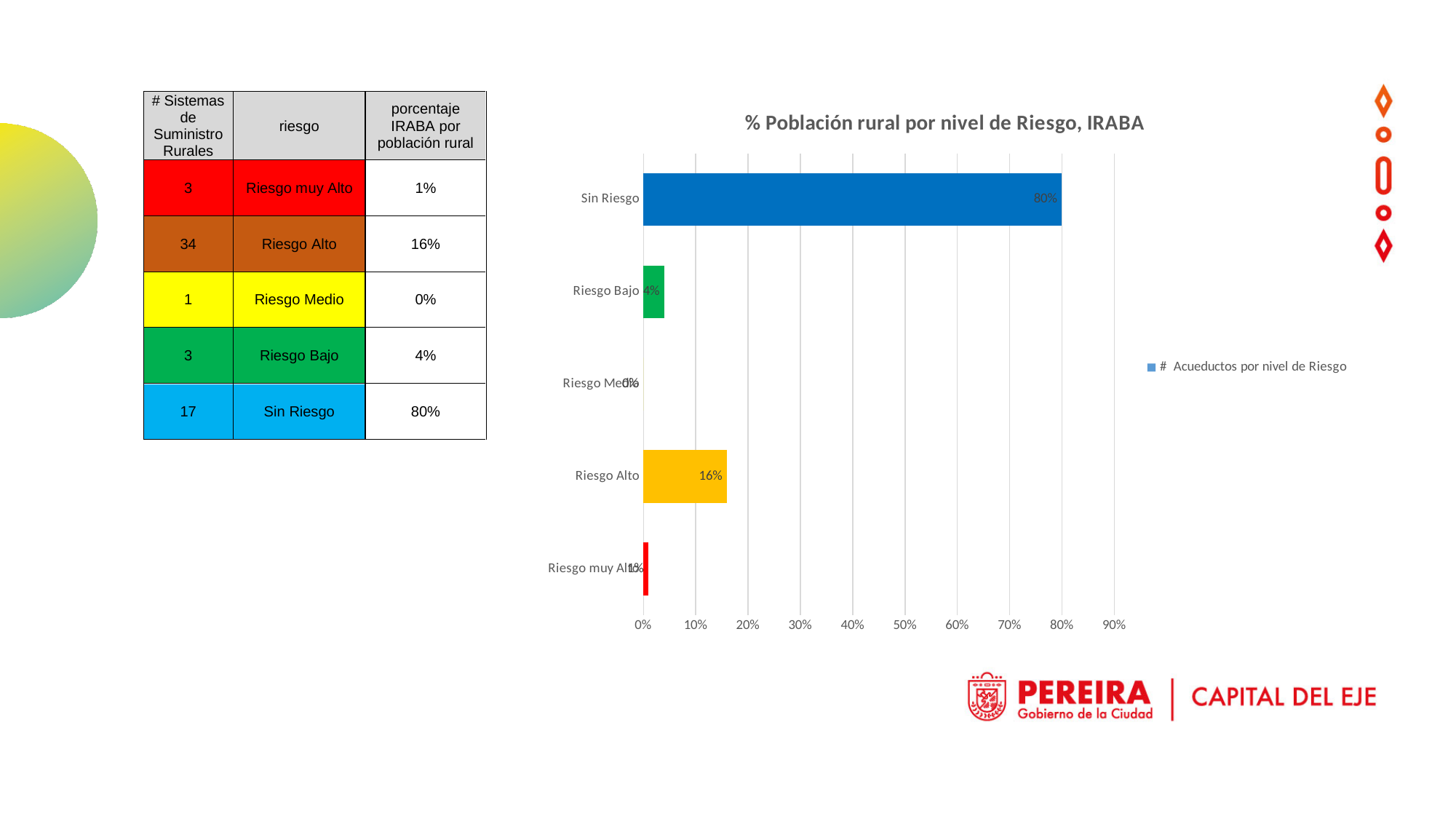
What is the legend entry shown in the chart? # Acueductos por nivel de Riesgo How many series does the legend list? 1 What type of chart is shown on the slide? bar chart Which category has the highest value in the chart? Sin Riesgo What is the difference between the values for Sin Riesgo and Riesgo Alto? 64% How many categories are shown in the chart? 5 What is the value for Sin Riesgo in the chart? 80% What is the value for Riesgo Alto in the chart? 16% What is the value for Riesgo Bajo in the chart? 4% Which is larger, the value for Riesgo Alto or the value for Riesgo Bajo? Riesgo Alto Is the value for Sin Riesgo greater or less than 50%? greater What is the title of the chart? % Población rural por nivel de Riesgo, IRABA